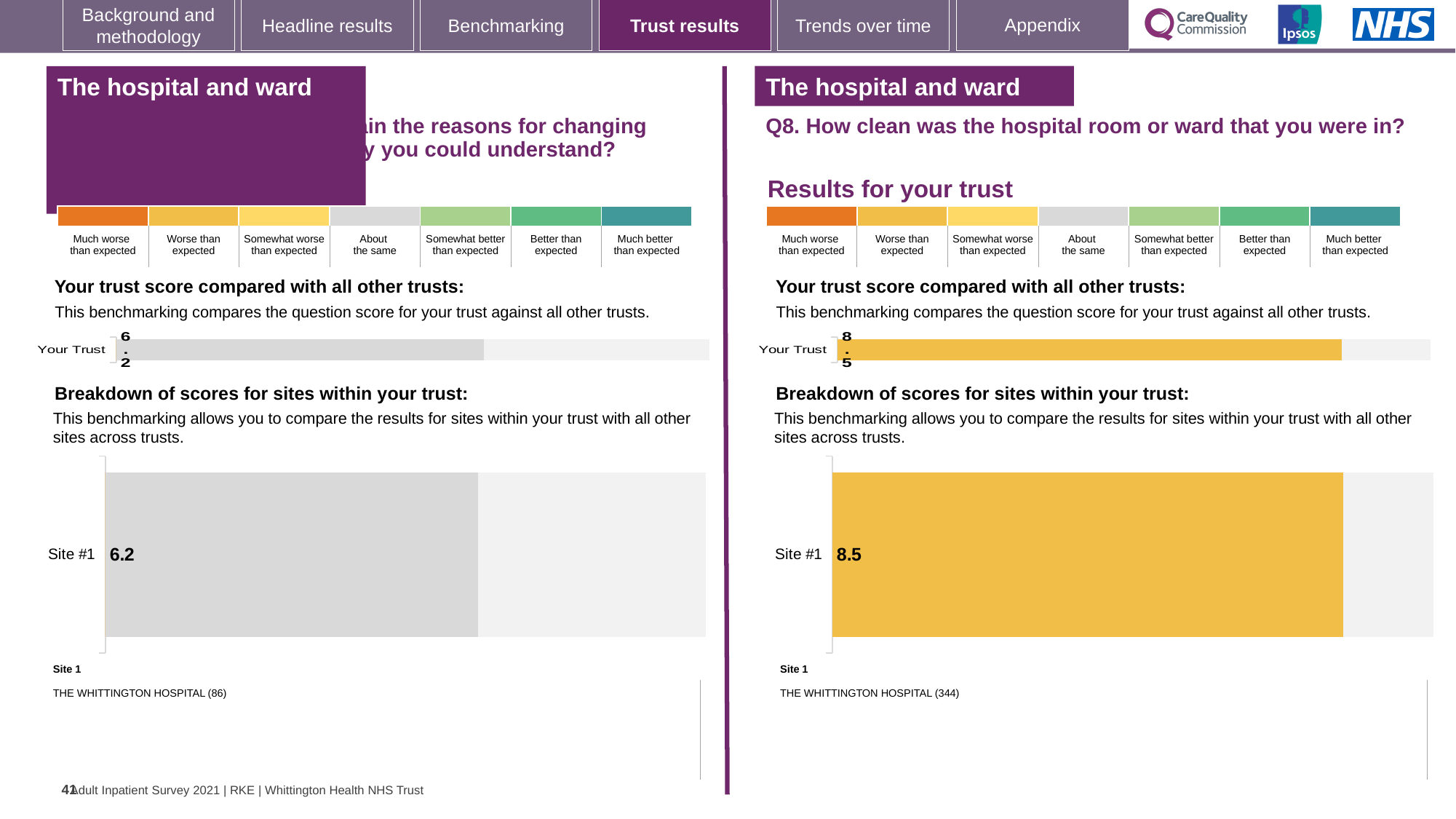
Which is larger: the Site #1 score on the left-hand chart or the Site #1 score on the right-hand chart for Q8? Right-hand chart (Q8) On the left-hand chart (the question about explaining reasons for changing wards), what is the score shown for Your Trust? 6.2 On the right-hand chart for Q8, which benchmark category does the colour of the Site #1 bar correspond to? Worse than expected Which site name is listed as Site 1 on the right-hand side for Q8? THE WHITTINGTON HOSPITAL (344) Is the Your Trust score on the left-hand chart the same as the Site #1 score on that chart? Yes How many sites are shown in the breakdown of scores on the right-hand chart for Q8? 1 On the left-hand chart, which benchmark category does the colour of the Site #1 bar correspond to? About the same On the right-hand chart for Q8 (How clean was the hospital room or ward that you were in?), what is the score shown for Your Trust? 8.5 What is the difference between the Your Trust score on the right-hand chart for Q8 and the Your Trust score on the left-hand chart? 2.3 What kind of chart is used to show the Site #1 score on the right-hand side for Q8? Bar chart On the left-hand chart, what is the score shown for Site #1? 6.2 On the right-hand chart for Q8, what is the score shown for Site #1? 8.5